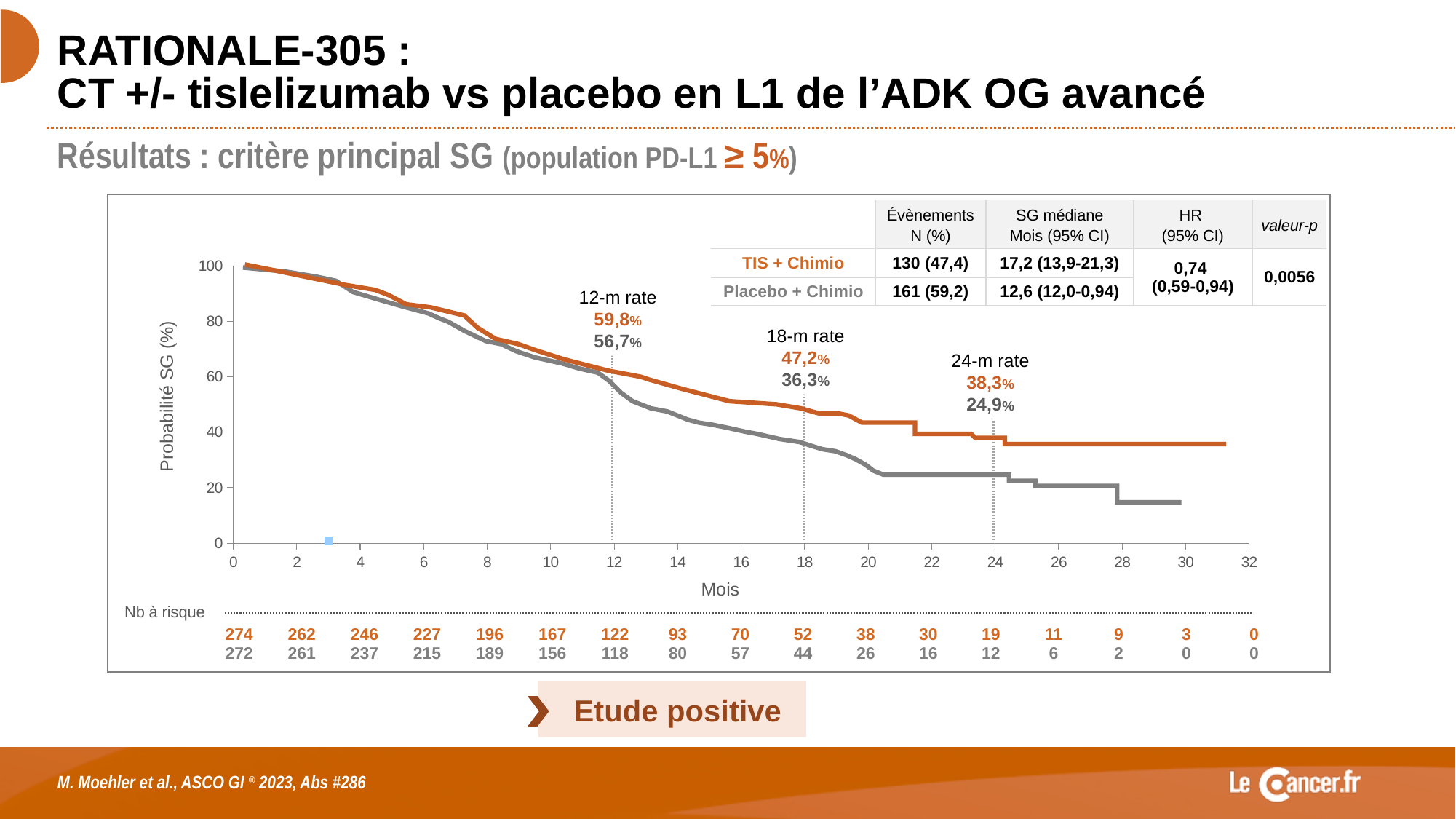
Do the survival curves rise or fall along the x axis? fall What is the median SG (months) for Placebo + Chimio? 12,6 How many patients were at risk in the TIS + Chimio arm at 12 months? 122 How many patients were at risk in the Placebo + Chimio arm at 0 months? 272 What is the 24-month survival rate for Placebo + Chimio? 24,9% What is the 12-month survival rate for TIS + Chimio? 59,8% What is the p-value shown in the table? 0,0056 What is the hazard ratio (HR) shown in the table? 0,74 Which arm has the higher 18-month survival rate, TIS + Chimio or Placebo + Chimio? TIS + Chimio What is the 18-month survival rate for TIS + Chimio? 47,2% Is the TIS + Chimio curve at 30 months greater or less than 40%? less What is the difference between the 24-month rates of TIS + Chimio and Placebo + Chimio? 13,4%